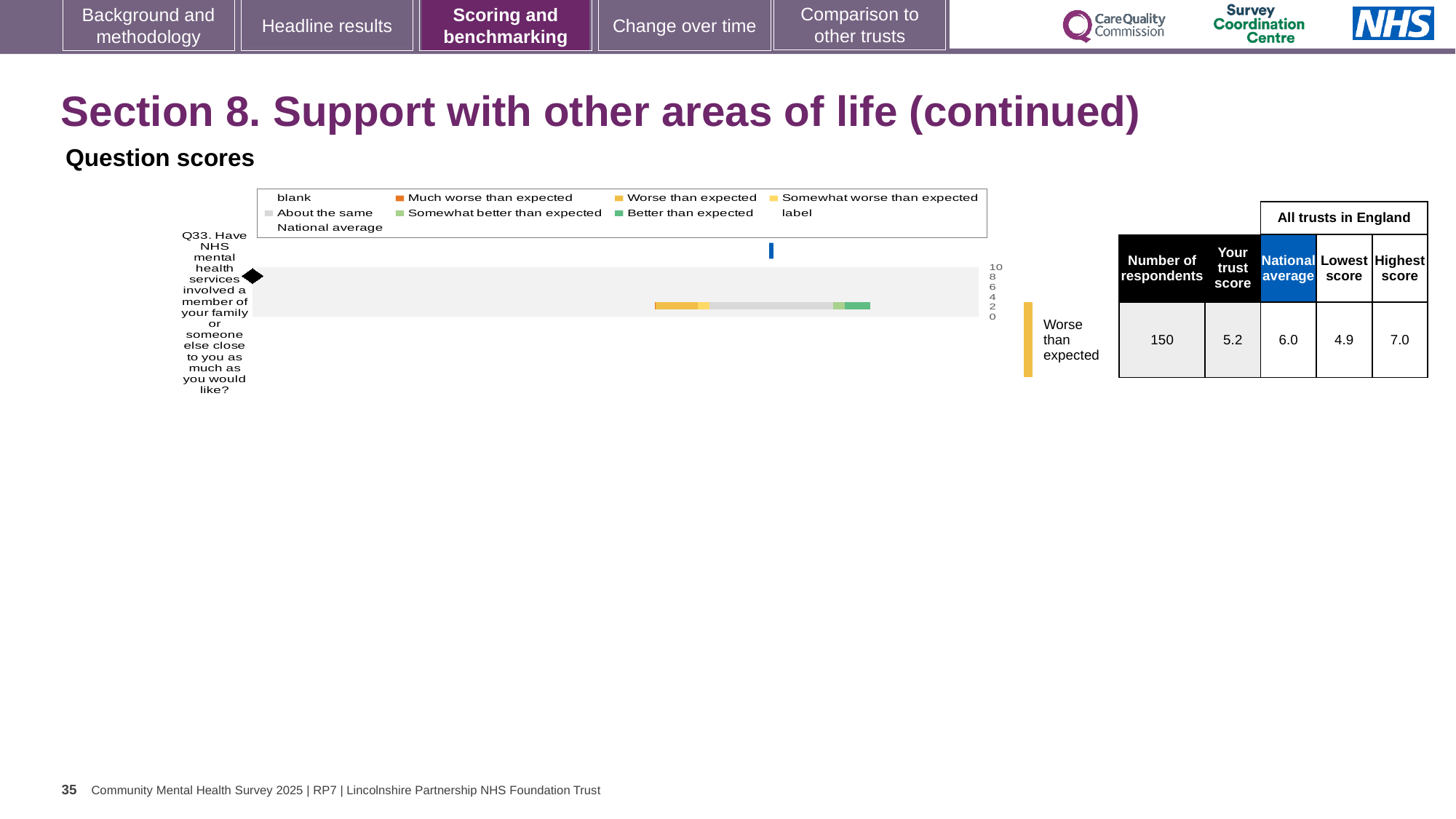
How many entries does the legend of the question scores chart list? 9 What is the national average score for Q33? 6.0 What is the difference between the national average and the trust's score for Q33? 0.8 What is the lowest score among all trusts in England for Q33? 4.9 What benchmark category label is shown to the right of the Q33 bar? Worse than expected What is the trust's score for Q33 according to the table beside the chart? 5.2 How many respondents answered Q33? 150 What is the highest score among all trusts in England for Q33? 7.0 How many survey questions are plotted in the question scores chart? 1 What kind of chart is used to show the Q33 question score? bar chart Which is larger for Q33, the trust's score or the national average? national average What is the highest value shown on the score axis of the question scores chart? 10